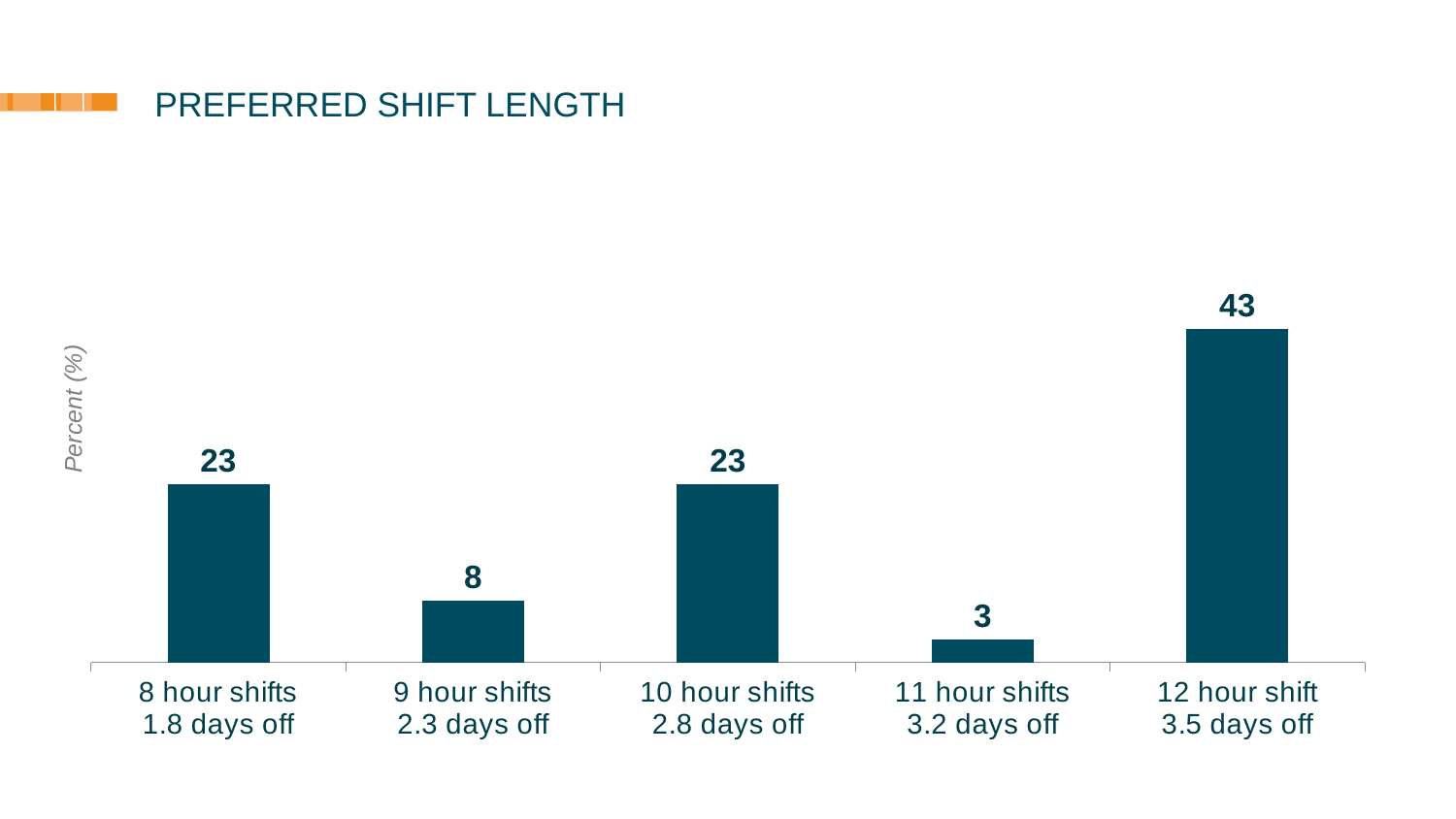
Which is larger, the value for 9 hour shifts or the value for 10 hour shifts? 10 hour shifts Which shift length has the highest value? 12 hour shift 3.5 days off What is the value for 9 hour shifts (2.3 days off)? 8 What is the title of the chart? PREFERRED SHIFT LENGTH What is the difference between the values for 9 hour shifts and 11 hour shifts? 5 What is the difference between the values for 12 hour shift and 10 hour shifts? 20 Which shift length has the lowest value? 11 hour shifts 3.2 days off What is the value for 11 hour shifts (3.2 days off)? 3 How many shift length categories are shown in the chart? 5 What kind of chart is shown on the slide? Bar chart What is the value for 12 hour shift (3.5 days off)? 43 What is the value for 8 hour shifts (1.8 days off)? 23